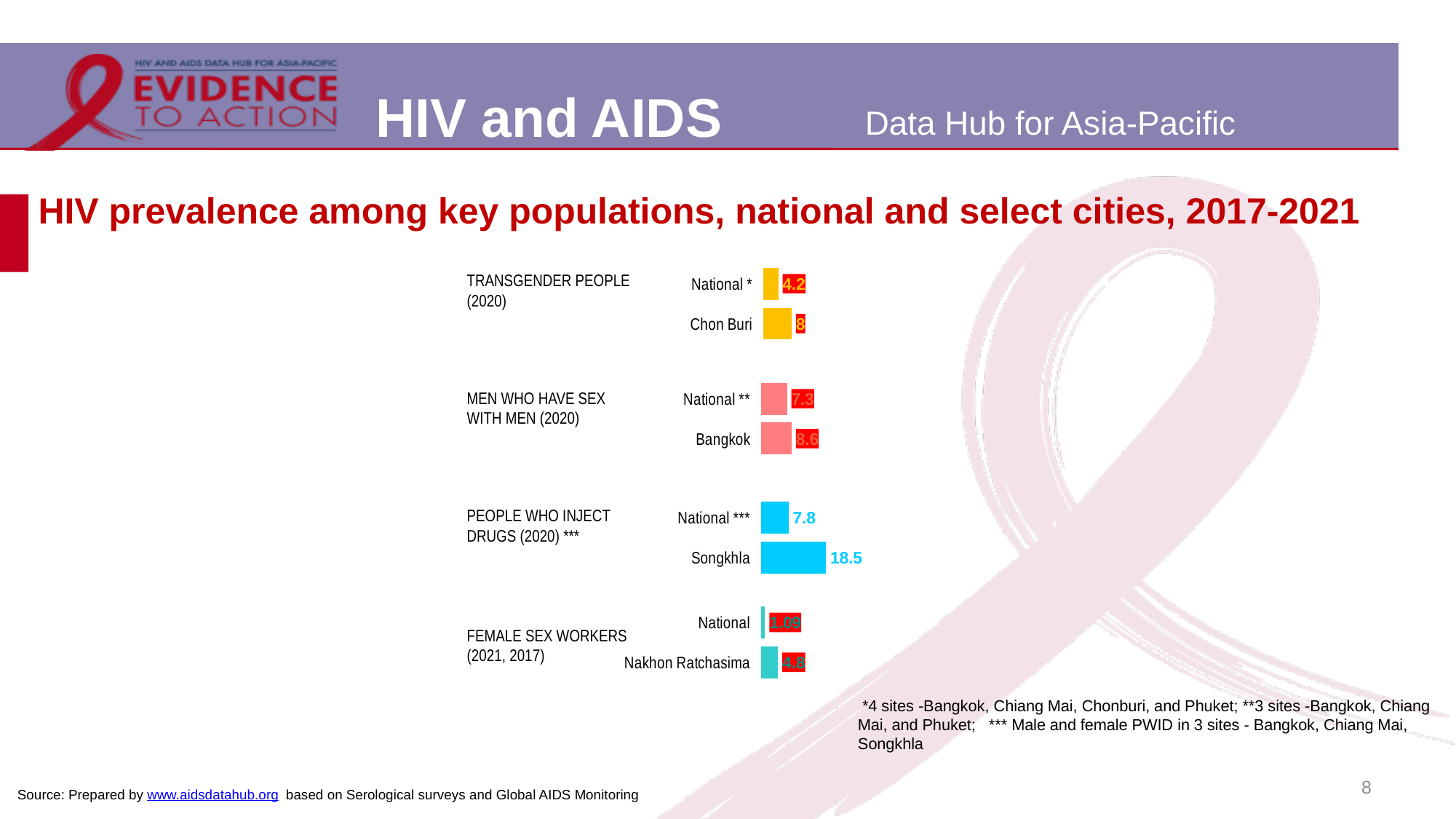
What is the difference between the Songkhla value and the national value for people who inject drugs? 10.7 What is the national HIV prevalence value shown for people who inject drugs (2020)? 7.8 What is the HIV prevalence value shown for Songkhla among people who inject drugs? 18.5 Which is larger, the Bangkok value for men who have sex with men or the national value for men who have sex with men? Bangkok What type of chart is shown on the slide? Bar chart What is the difference between the Chon Buri value and the national value for transgender people? 3.8 What is the HIV prevalence value shown for Chon Buri among transgender people? 8 Which is larger, the Nakhon Ratchasima value or the national value for female sex workers? Nakhon Ratchasima What is the national HIV prevalence value shown for men who have sex with men (2020)? 7.3 How many bars are plotted in the chart? 8 Which bar in the chart has the highest value? Songkhla (people who inject drugs) What is the HIV prevalence value shown for Nakhon Ratchasima among female sex workers? 4.8